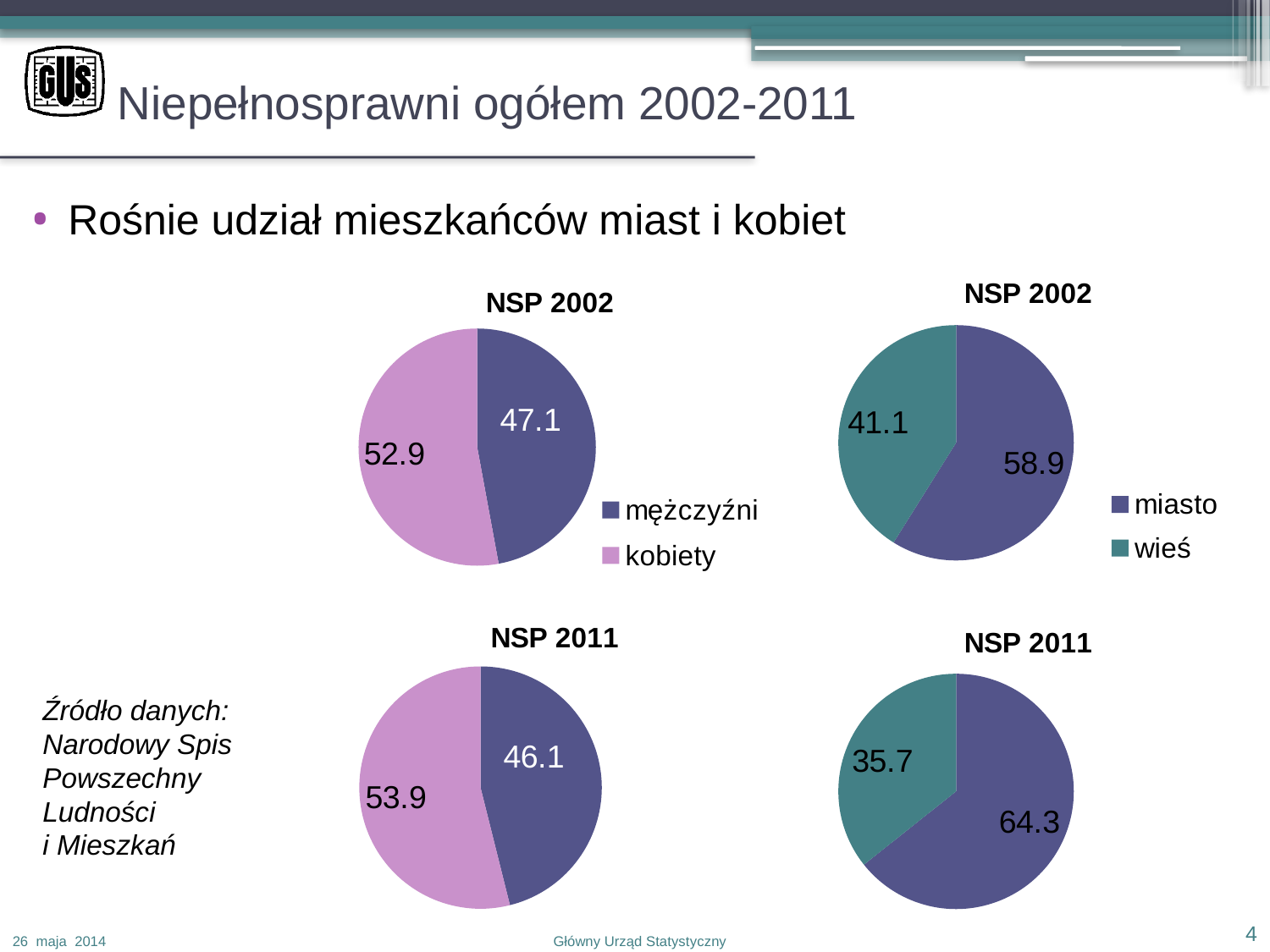
What type of chart is used on this slide? pie chart In the top-left pie chart (NSP 2002, mężczyźni/kobiety), what is the value for kobiety? 52.9 In the bottom-right pie chart (NSP 2011, miasto/wieś), what is the difference between the miasto and wieś values? 28.6 Comparing the top-right (NSP 2002) and bottom-right (NSP 2011) pie charts, which year has the larger miasto value? NSP 2011 In the top-left pie chart (NSP 2002, mężczyźni/kobiety), what is the value for mężczyźni? 47.1 How many pie charts are shown on the slide? 4 In the top-right pie chart (NSP 2002, miasto/wieś), what is the difference between the miasto and wieś values? 17.8 In the bottom-right pie chart (NSP 2011, miasto/wieś), what is the value for wieś? 35.7 In the top-right pie chart (NSP 2002, miasto/wieś), what is the value for miasto? 58.9 In the bottom-right pie chart (NSP 2011, miasto/wieś), which category has the larger share? miasto In the bottom-left pie chart (NSP 2011, mężczyźni/kobiety), what is the value for kobiety? 53.9 In the bottom-left pie chart (NSP 2011, mężczyźni/kobiety), which category has the smaller share? mężczyźni